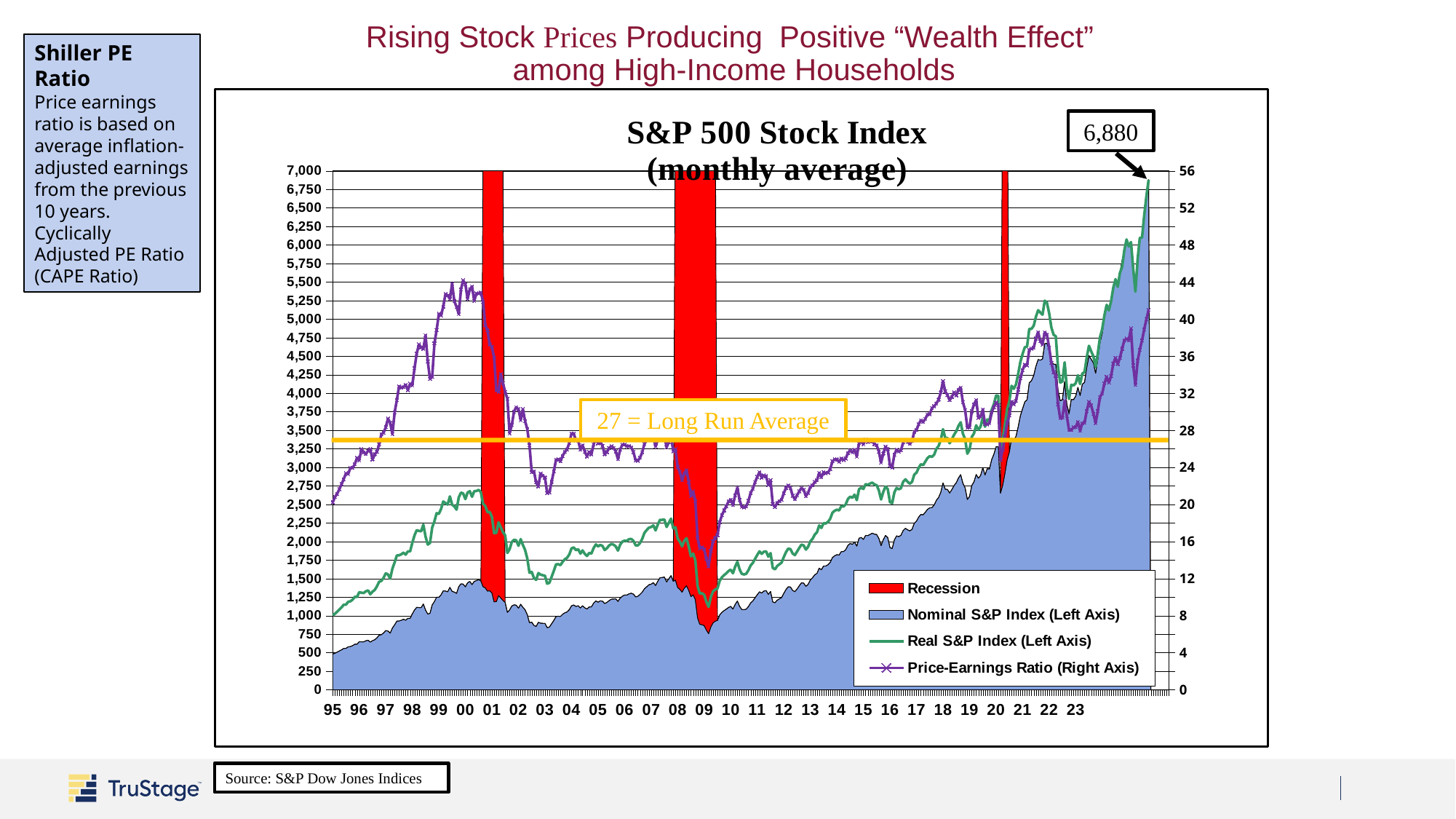
Is the Nominal S&P Index at its 2009 low greater or less than 1,000? less In 2000, which is higher: the Real S&P Index or the Nominal S&P Index? Real S&P Index How many entries does the chart legend list? 4 Is the Price-Earnings Ratio at its 2009 low greater or less than 16? less What is the title of the chart? S&P 500 Stock Index (monthly average) Does the Nominal S&P Index rise or fall from 2009 to the end of the chart? rise How many recession periods are shaded on the chart? 3 Is the Price-Earnings Ratio at the end of the chart greater or less than 36? greater What value is labelled as the long run average on the chart? 27 What value is called out in the annotation box at the end of the S&P 500 series? 6,880 On which axis is the Price-Earnings Ratio plotted? Right axis